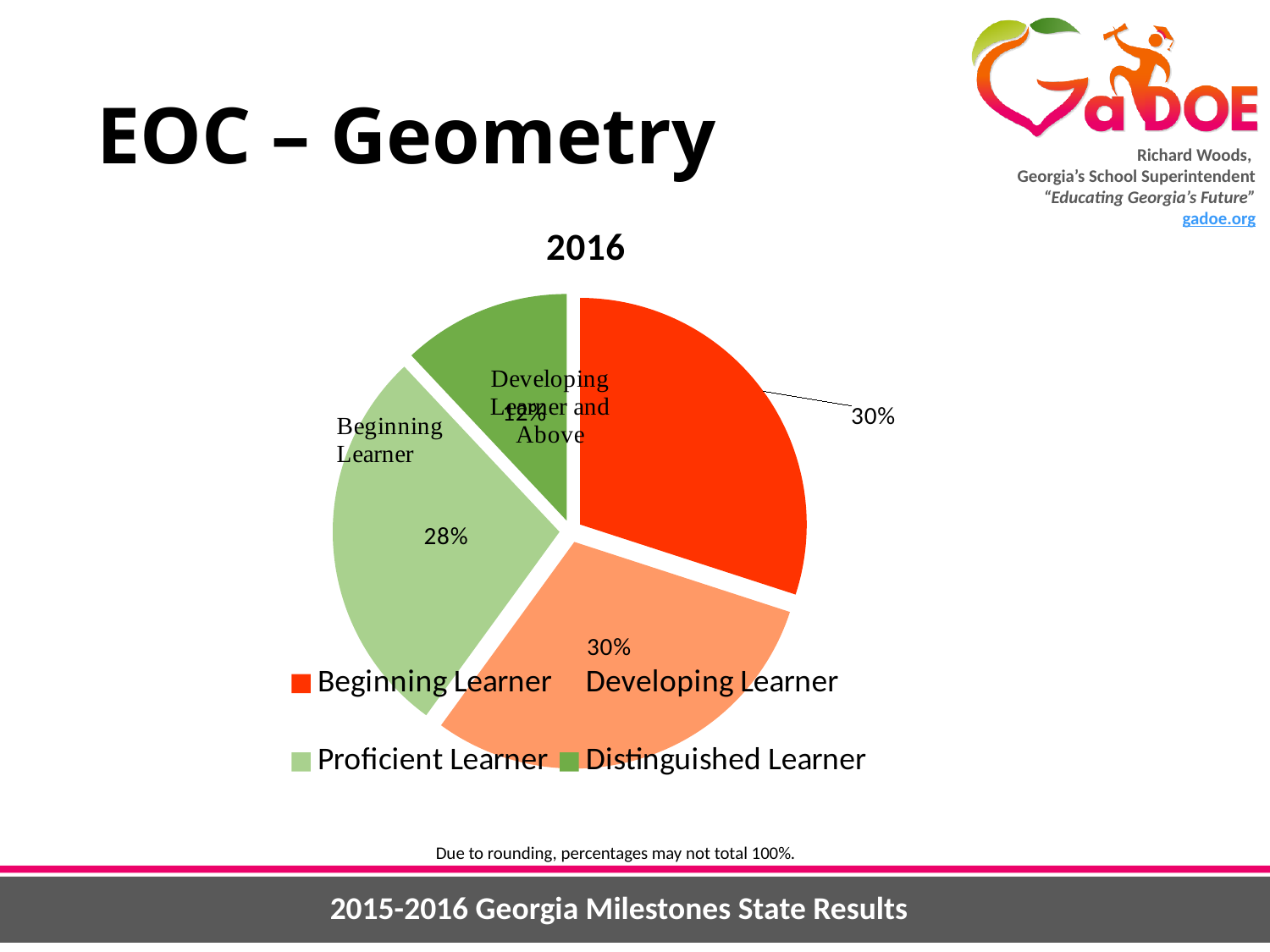
Which category has the smallest slice of the pie? Distinguished Learner How many slices does the pie chart have? 4 What is the difference in percentage points between the Developing Learner slice and the Proficient Learner slice? 2 What kind of chart is shown on the slide? pie chart What is the title of the pie chart? 2016 How many entries does the legend list? 4 What percentage of the pie is Distinguished Learner? 12% What percentage of the pie is Developing Learner? 30% Which is larger, the Proficient Learner slice or the Distinguished Learner slice? Proficient Learner What percentage of the pie is Proficient Learner? 28% What percentage of the pie is Beginning Learner? 30% What is the difference in percentage points between the Beginning Learner slice and the Distinguished Learner slice? 18